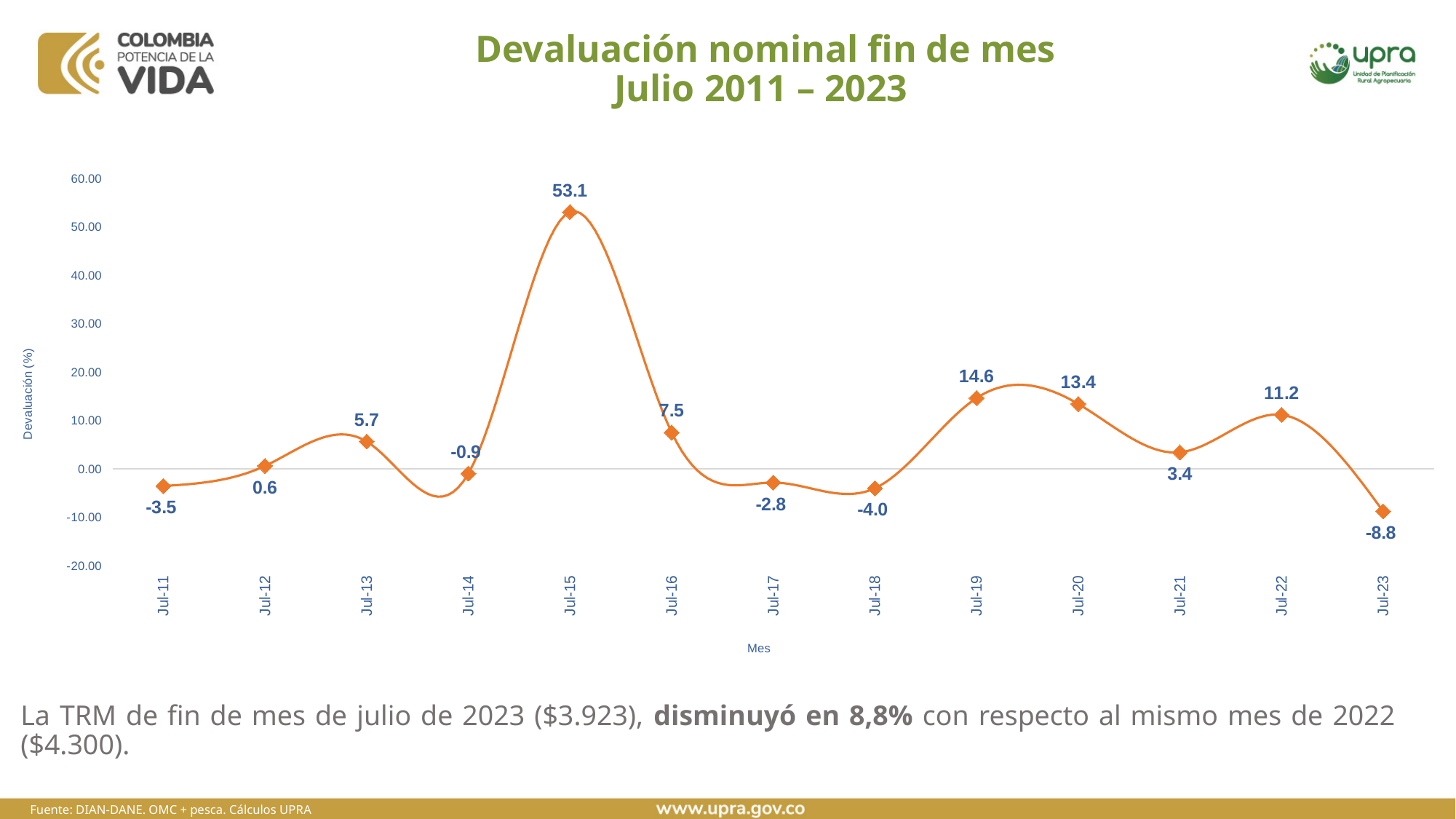
What is the value for Jul-19? 14.6 Is the value for Jul-15 greater or less than 50.00? greater What is the label of the vertical axis? Devaluación (%) Which month has the lowest value? Jul-23 What is the difference between the values for Jul-19 and Jul-20? 1.2 Do the values rise or fall from Jul-22 to Jul-23? fall Which month has the highest value? Jul-15 What is the value for Jul-15? 53.1 How many data points are plotted on the chart? 13 What kind of chart is shown on the slide? line chart Which is larger, the value for Jul-13 or the value for Jul-16? Jul-16 What is the value for Jul-23? -8.8